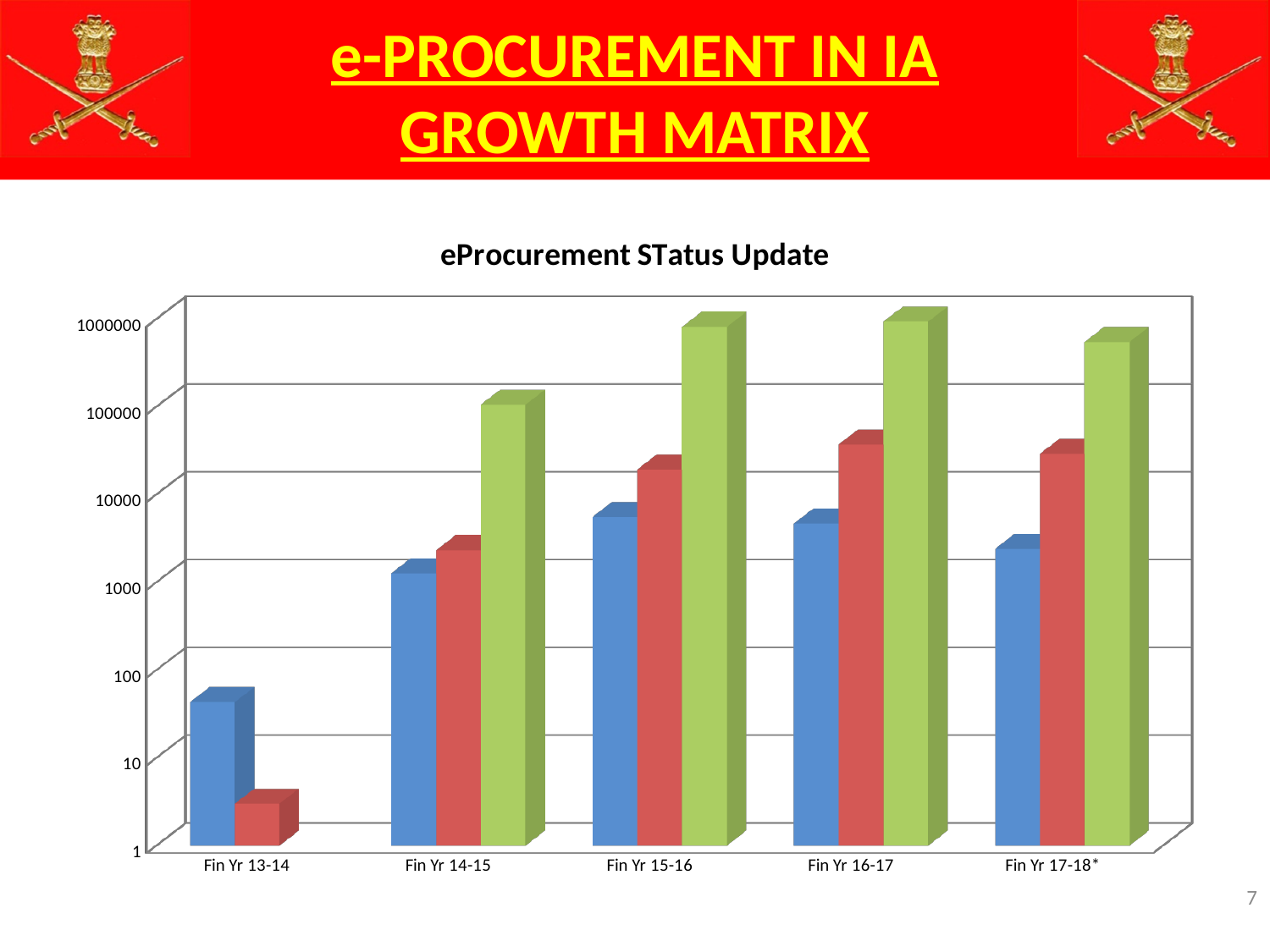
Is the value of the blue bar for Fin Yr 13-14 greater or less than 100? less What kind of chart is shown on the slide? bar chart Is the value of the red bar for Fin Yr 16-17 greater or less than 10000? greater What is the title of the chart? eProcurement STatus Update Which category has the lowest blue bar? Fin Yr 13-14 Do the blue bars rise or fall from Fin Yr 13-14 to Fin Yr 14-15? rise Which category has no green bar? Fin Yr 13-14 Is the value of the green bar for Fin Yr 15-16 greater or less than 100000? greater For Fin Yr 15-16, which is larger, the green bar or the red bar? the green bar How many financial year categories are shown on the x axis? 5